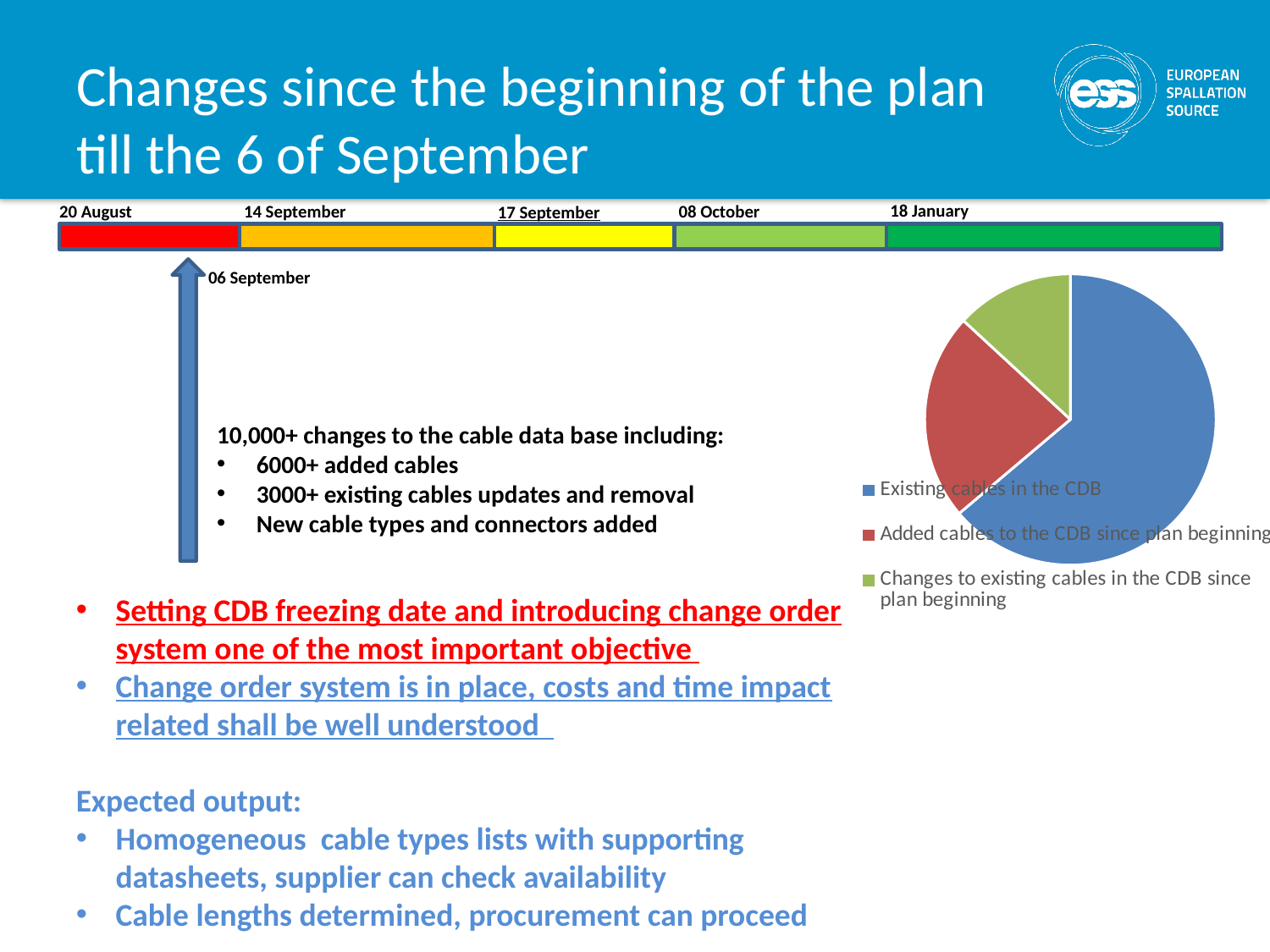
Which category takes the largest share of the pie chart? Existing cables in the CDB Which slice is larger in the pie chart: 'Existing cables in the CDB' or 'Added cables to the CDB since plan beginning'? Existing cables in the CDB What kind of chart is shown on the right side of the slide? pie chart How many slices does the pie chart have? 3 Which category is shown in green in the pie chart? Changes to existing cables in the CDB since plan beginning Does the 'Existing cables in the CDB' slice take up more or less than half of the pie chart? more What colour is the 'Existing cables in the CDB' slice in the pie chart? blue Which category takes the smallest share of the pie chart? Changes to existing cables in the CDB since plan beginning How many entries does the legend of the pie chart list? 3 Which slice is larger in the pie chart: 'Added cables to the CDB since plan beginning' or 'Changes to existing cables in the CDB since plan beginning'? Added cables to the CDB since plan beginning